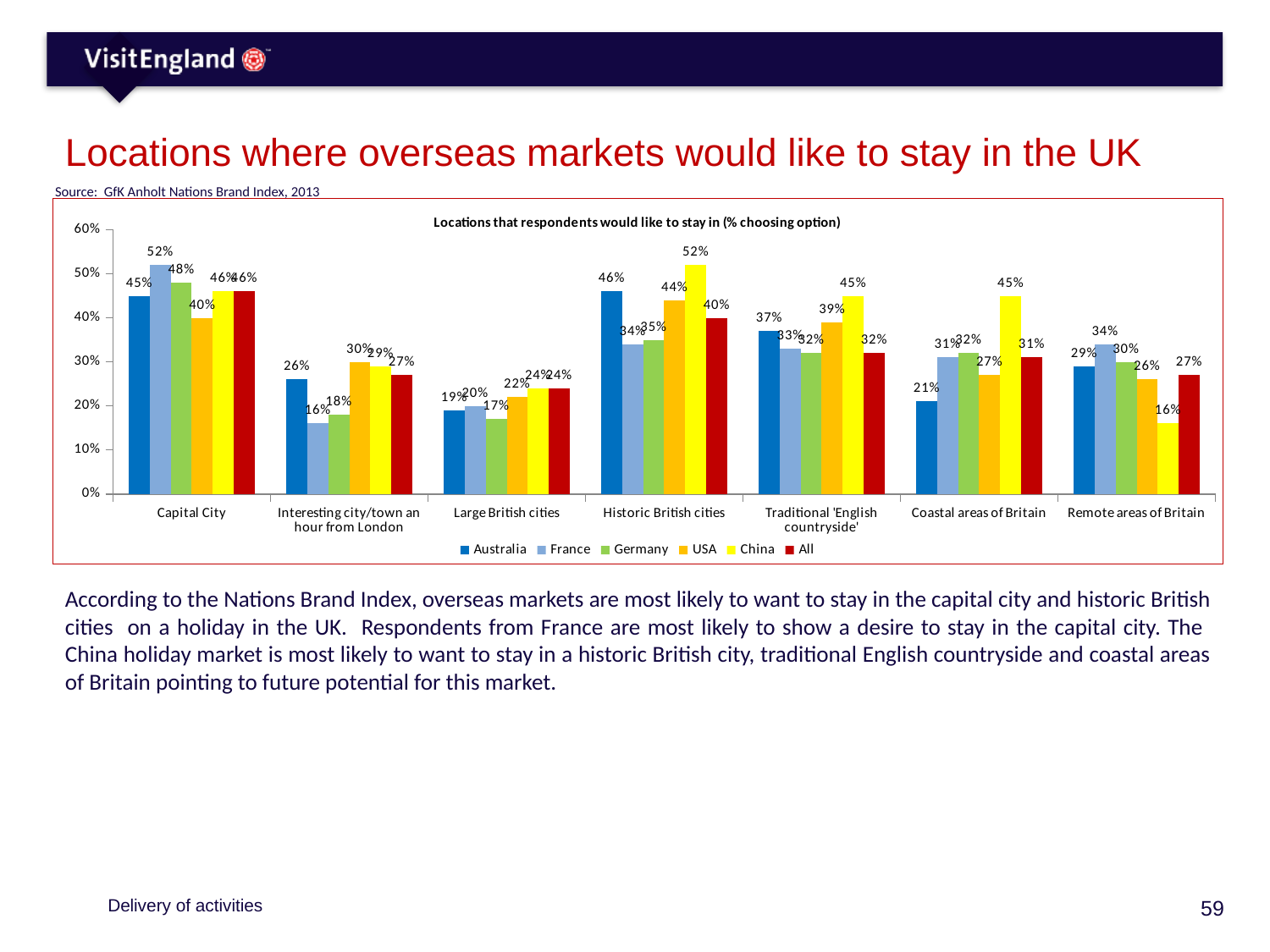
Which is larger for Interesting city/town an hour from London: the value for Australia or the value for France? Australia What percentage of Chinese respondents would like to stay in Historic British cities? 52% What is the difference between the China and USA values for Historic British cities? 8% Which market has the highest value for Coastal areas of Britain? China Which market has the lowest value for Remote areas of Britain? China How many location categories are shown on the x axis? 7 What is the title of the chart? Locations that respondents would like to stay in (% choosing option) How many series does the legend list? 6 What percentage of French respondents would like to stay in the Capital City? 52% What is the value for Australia in the Coastal areas of Britain category? 21% What kind of chart is shown on the slide? Bar chart What is the value for USA in the Traditional 'English countryside' category? 39%